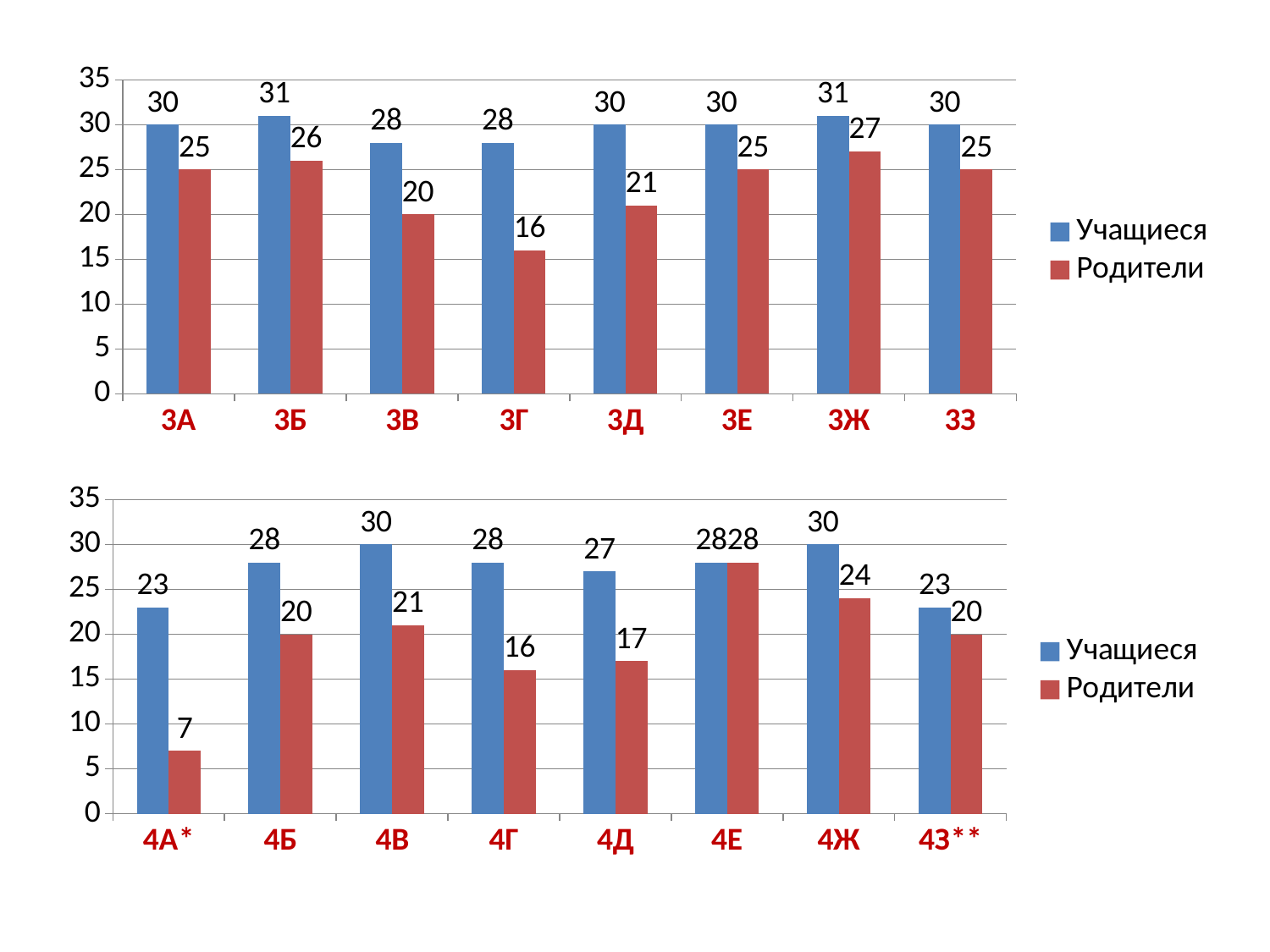
In the top chart, which category has the lowest value for Родители? 3Г In the top chart, which is larger in 3В: Учащиеся or Родители? Учащиеся How many categories does the bottom chart show? 8 In the top chart, what is the value for Родители in 3Г? 16 What kind of chart is the top chart? bar chart In the bottom chart, what is the value for Родители in 4А*? 7 In the bottom chart, what is the difference between Учащиеся and Родители in 4А*? 16 How many series does the legend of the top chart list? 2 In the top chart, what is the value for Учащиеся in 3Б? 31 In the bottom chart, what is the value for Учащиеся in 4Д? 27 In the bottom chart, which category has the highest value for Родители? 4Е In the top chart, which category has the highest value for Родители? 3Ж